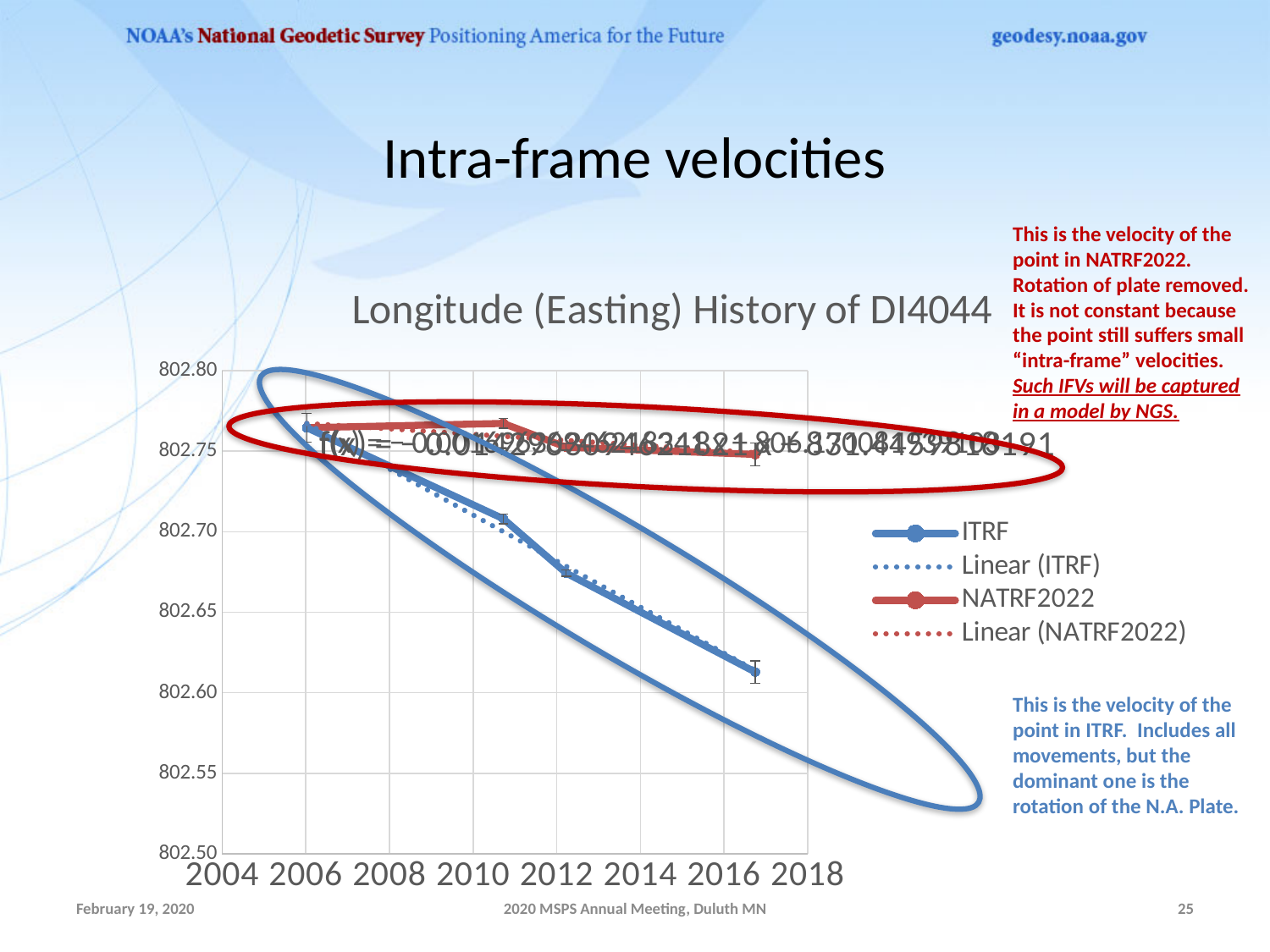
How many series does the chart legend list? 4 Which series shows the larger overall decline across the chart, ITRF or NATRF2022? ITRF Which series is drawn in red in the chart? NATRF2022 Is the ITRF value at the point near 2012 greater or less than 802.70? less Is the ITRF value at the last plotted point (around 2016) greater or less than 802.65? less What kind of chart is shown on the slide? line chart Is the NATRF2022 value at the last plotted point (around 2016) greater or less than 802.70? greater Does the ITRF series rise or fall from 2006 to 2016? fall At the last plotted point (around 2016), which series has the higher value, ITRF or NATRF2022? NATRF2022 What is the lowest value shown on the vertical axis of the chart? 802.50 What is the title of the chart? Longitude (Easting) History of DI4044